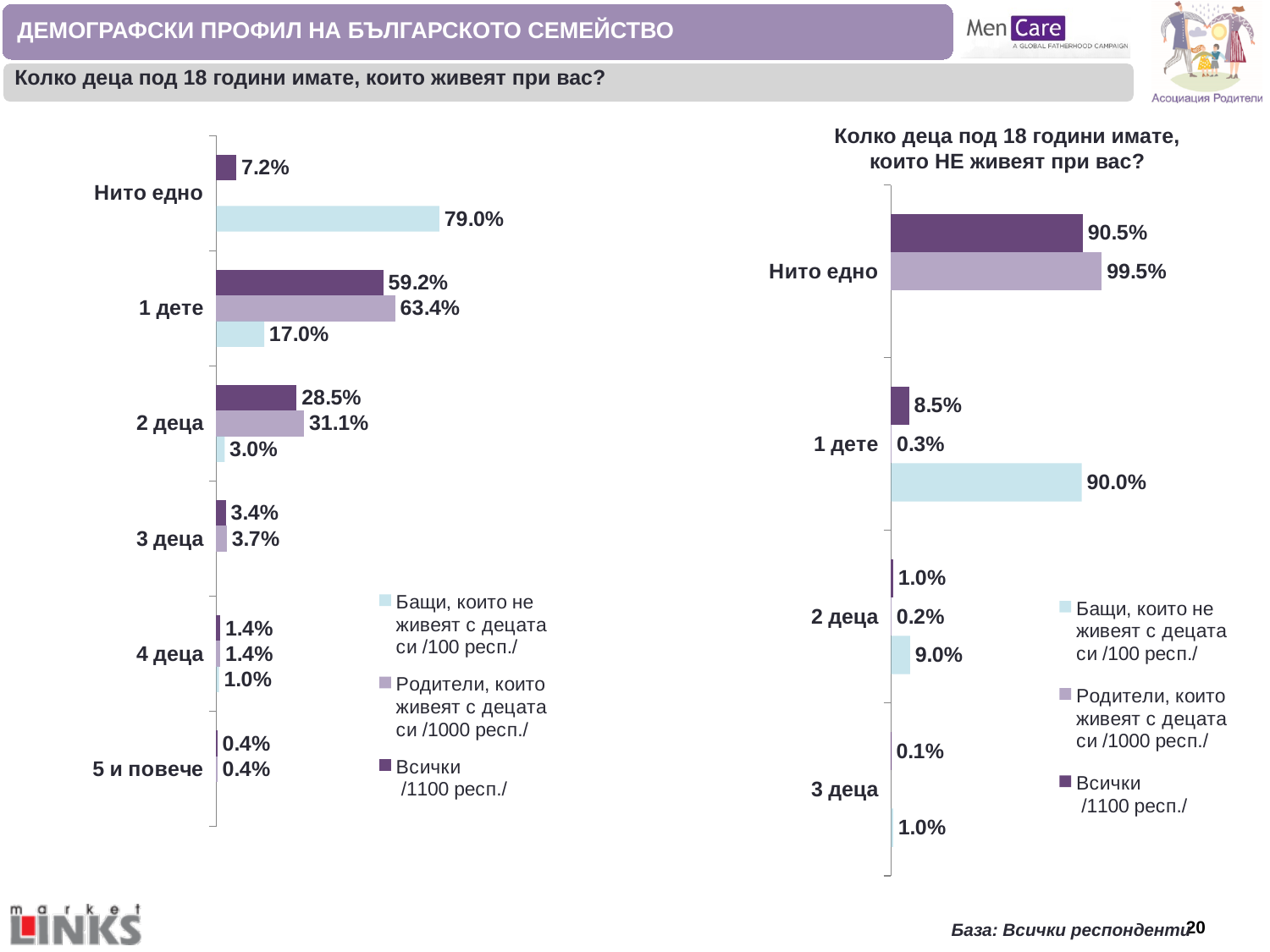
In the right chart, what is the value for 'Родители, които живеят с децата си' in the 'Нито едно' category? 99.5% How many categories are shown on the left chart? 6 In the right chart, which is larger for 'Нито едно': the 'Всички' value or the 'Родители' value? Родители In the left chart, which category has the highest value for 'Всички'? 1 дете In the right chart, which category has the lowest value for 'Всички'? 3 деца In the right chart, what is the value for 'Бащи, които не живеят с децата си' in the '1 дете' category? 90.0% In the left chart, what is the value for 'Бащи, които не живеят с децата си' in the 'Нито едно' category? 79.0% How many series does the legend of the right chart list? 3 In the left chart, what is the value for 'Всички' in the '1 дете' category? 59.2% In the left chart, what is the value for 'Родители, които живеят с децата си' in the '2 деца' category? 31.1% In the left chart, what is the difference between the 'Родители' and 'Всички' values for '1 дете'? 4.2% What type of chart is the right chart? Bar chart